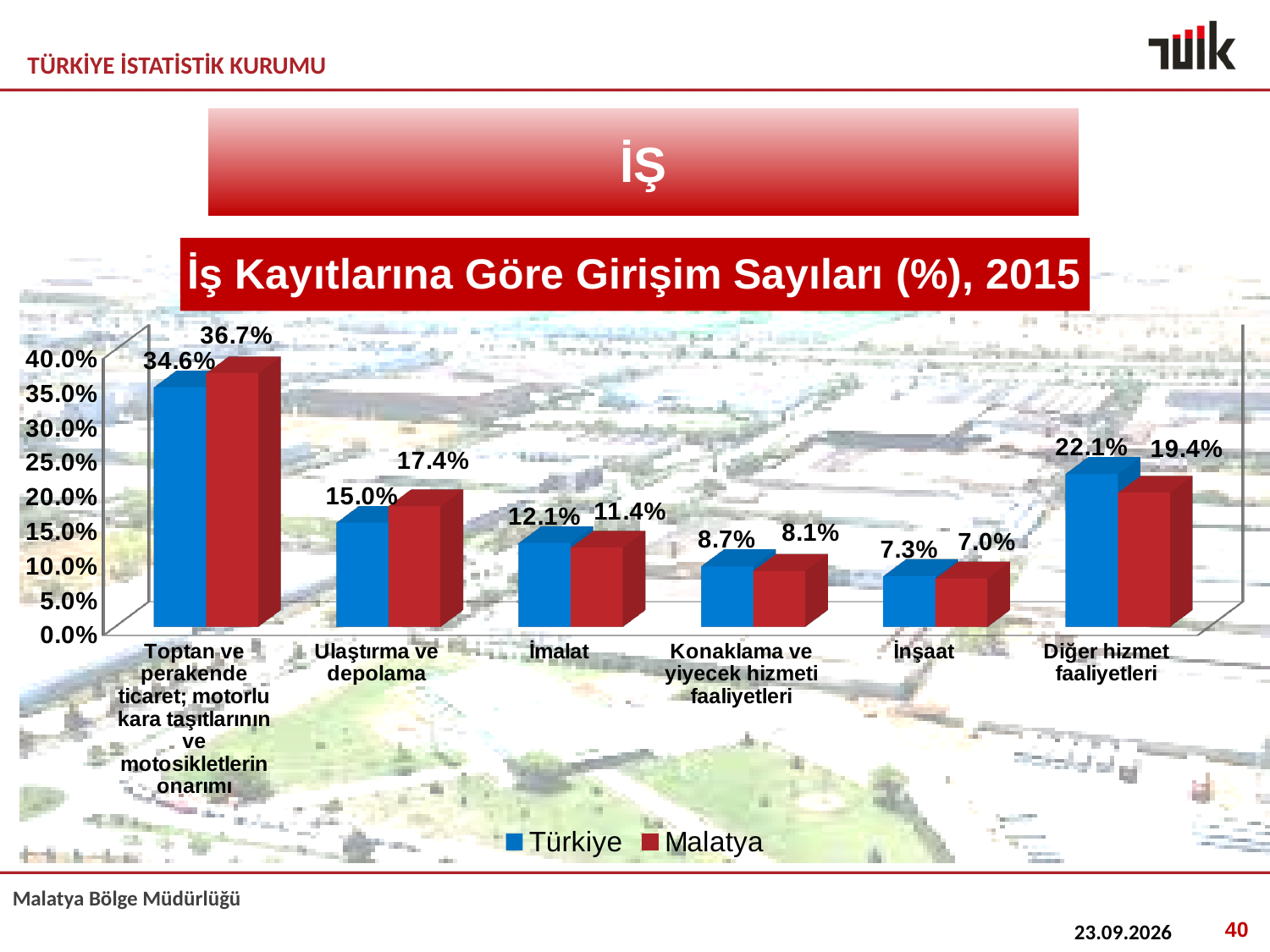
Which category has the lowest Türkiye value? İnşaat What kind of chart is shown on the slide? Bar chart For Ulaştırma ve depolama, which is larger: the Türkiye value or the Malatya value? Malatya What is the difference between the Türkiye and Malatya values for Diğer hizmet faaliyetleri? 2.7% Which category has the highest Malatya value? Toptan ve perakende ticaret; motorlu kara taşıtlarının ve motosikletlerin onarımı How many series does the legend list? 2 What is the title of the chart? İş Kayıtlarına Göre Girişim Sayıları (%), 2015 What is the Malatya value for Diğer hizmet faaliyetleri? 19.4% What is the Malatya value for Ulaştırma ve depolama? 17.4% What is the difference between the Malatya and Türkiye values for Toptan ve perakende ticaret; motorlu kara taşıtlarının ve motosikletlerin onarımı? 2.1% What is the Türkiye value for İmalat? 12.1% How many categories are shown on the x axis? 6